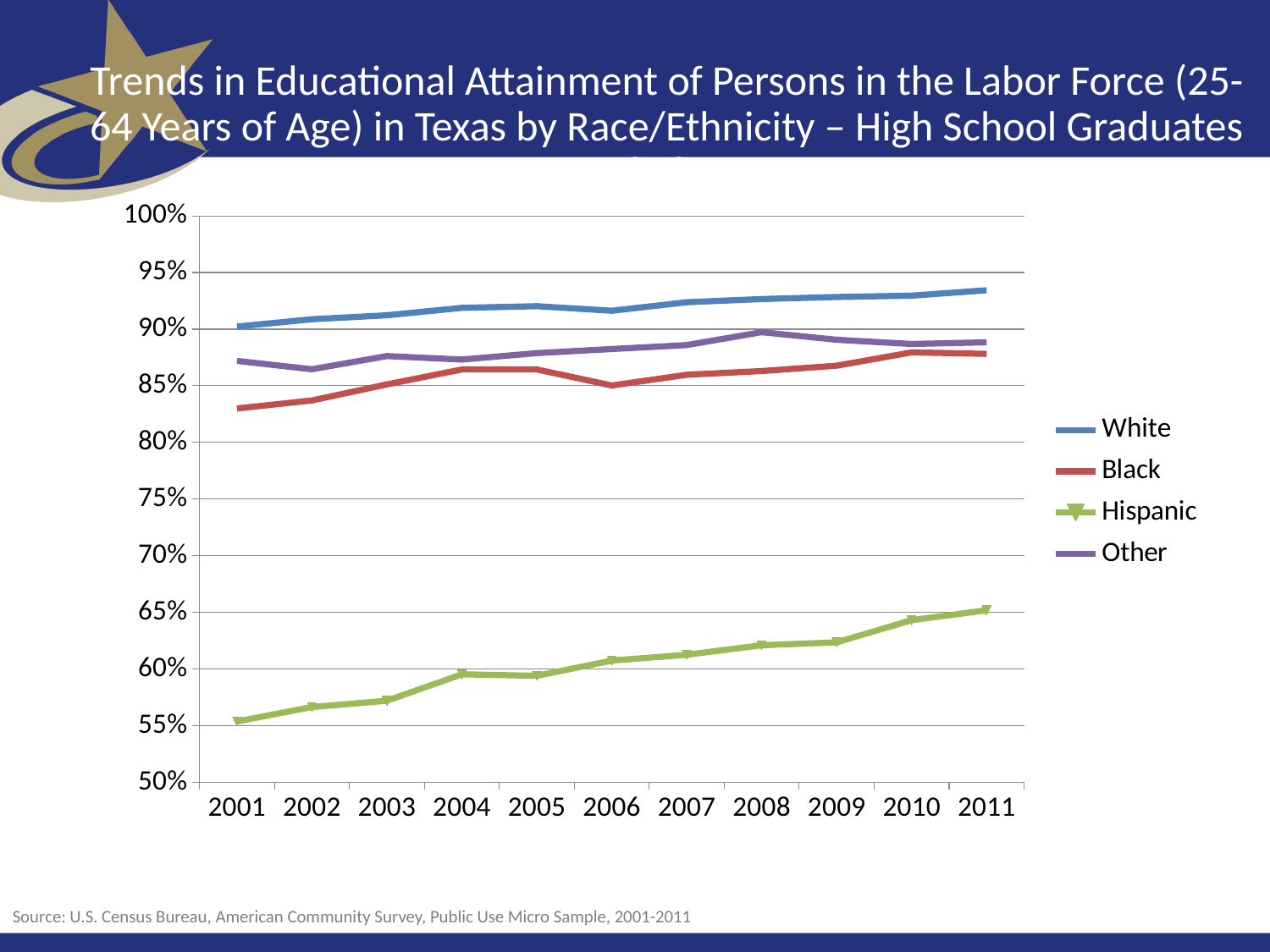
Which series has the lowest value in 2011? Hispanic Which series is shown in green in the legend? Hispanic Is the value for Other in 2008 greater or less than 85%? greater Does the Hispanic line rise or fall from 2001 to 2011? Rise Is the value for White in 2011 greater or less than 90%? greater Is the value for Hispanic in 2001 greater or less than 60%? less Which series has the highest value in 2011? White How many years are shown along the x axis? 11 What kind of chart is shown on the slide? Line chart How many series does the legend list? 4 In 2008, which series has the larger value, Black or Other? Other